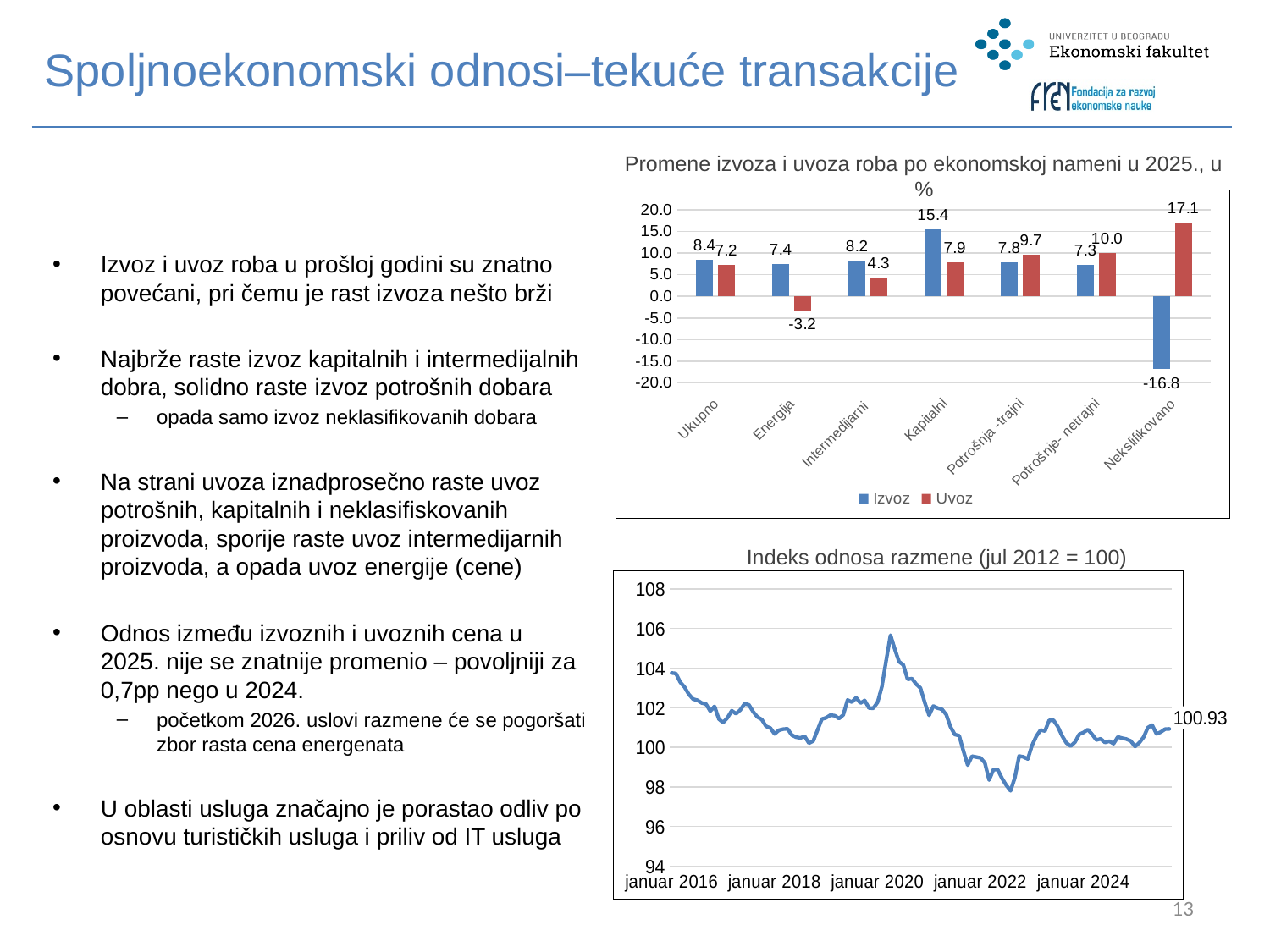
What kind of chart is 'Indeks odnosa razmene (jul 2012 = 100)'? Line chart In the chart 'Promene izvoza i uvoza roba po ekonomskoj nameni u 2025., u %', which category has the lowest Izvoz value? Nekslifikovano In the chart 'Promene izvoza i uvoza roba po ekonomskoj nameni u 2025., u %', what is the Uvoz value for Energija? -3.2 In the chart 'Promene izvoza i uvoza roba po ekonomskoj nameni u 2025., u %', which is larger for Potrošnje- netrajni, Izvoz or Uvoz? Uvoz In the chart 'Indeks odnosa razmene (jul 2012 = 100)', is the peak value of the line greater or less than 104? greater What kind of chart is 'Promene izvoza i uvoza roba po ekonomskoj nameni u 2025., u %'? Bar chart In the chart 'Indeks odnosa razmene (jul 2012 = 100)', what is the value shown at the end of the line? 100.93 In the chart 'Promene izvoza i uvoza roba po ekonomskoj nameni u 2025., u %', what is the difference between the Izvoz and Uvoz values for Intermedijarni? 3.9 How many categories are shown on the x axis of the chart 'Promene izvoza i uvoza roba po ekonomskoj nameni u 2025., u %'? 7 In the chart 'Promene izvoza i uvoza roba po ekonomskoj nameni u 2025., u %', which category has the highest Uvoz value? Nekslifikovano How many series does the legend of the chart 'Promene izvoza i uvoza roba po ekonomskoj nameni u 2025., u %' list? 2 In the chart 'Promene izvoza i uvoza roba po ekonomskoj nameni u 2025., u %', what is the Izvoz value for Kapitalni? 15.4